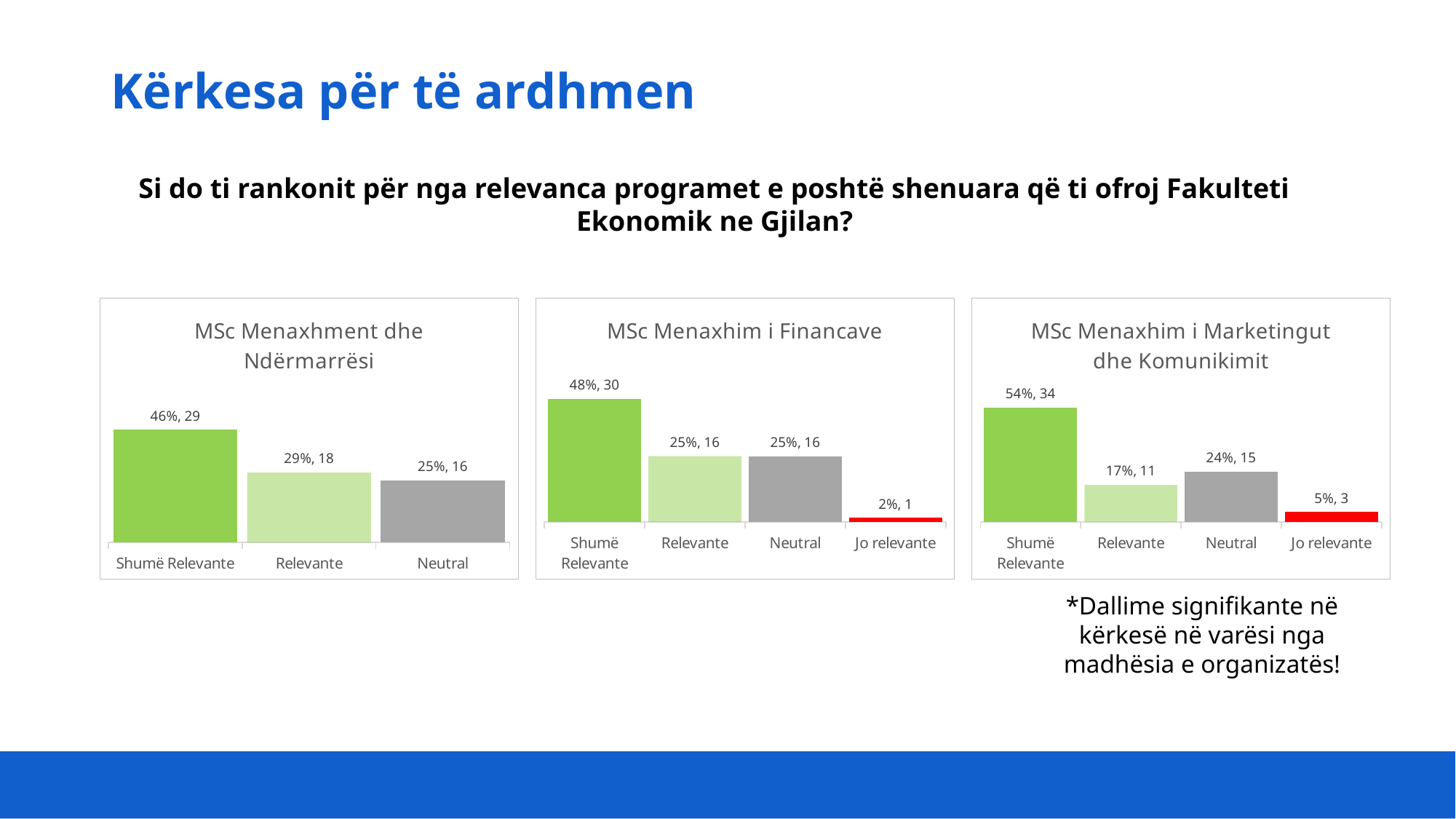
In the 'MSc Menaxhim i Marketingut dhe Komunikimit' chart, which is larger: Relevante or Neutral? Neutral In the 'MSc Menaxhim i Marketingut dhe Komunikimit' chart, what is the difference in percentage between Shumë Relevante and Relevante? 37% How many categories are shown in the 'MSc Menaxhment dhe Ndërmarrësi' chart? 3 In the 'MSc Menaxhim i Marketingut dhe Komunikimit' chart, which category has the highest value? Shumë Relevante In the 'MSc Menaxhment dhe Ndërmarrësi' chart, what is the difference in count between Shumë Relevante and Relevante? 11 In the 'MSc Menaxhim i Financave' chart, what is the data label for Jo relevante? 2%, 1 What type of chart is the 'MSc Menaxhim i Financave' chart? Bar chart How many categories are shown in the 'MSc Menaxhim i Financave' chart? 4 In the 'MSc Menaxhim i Financave' chart, what colour is the Jo relevante bar? Red In the 'MSc Menaxhim i Marketingut dhe Komunikimit' chart, what is the data label for Neutral? 24%, 15 In the 'MSc Menaxhment dhe Ndërmarrësi' chart, what is the data label for Shumë Relevante? 46%, 29 In the 'MSc Menaxhim i Financave' chart, which category has the lowest value? Jo relevante